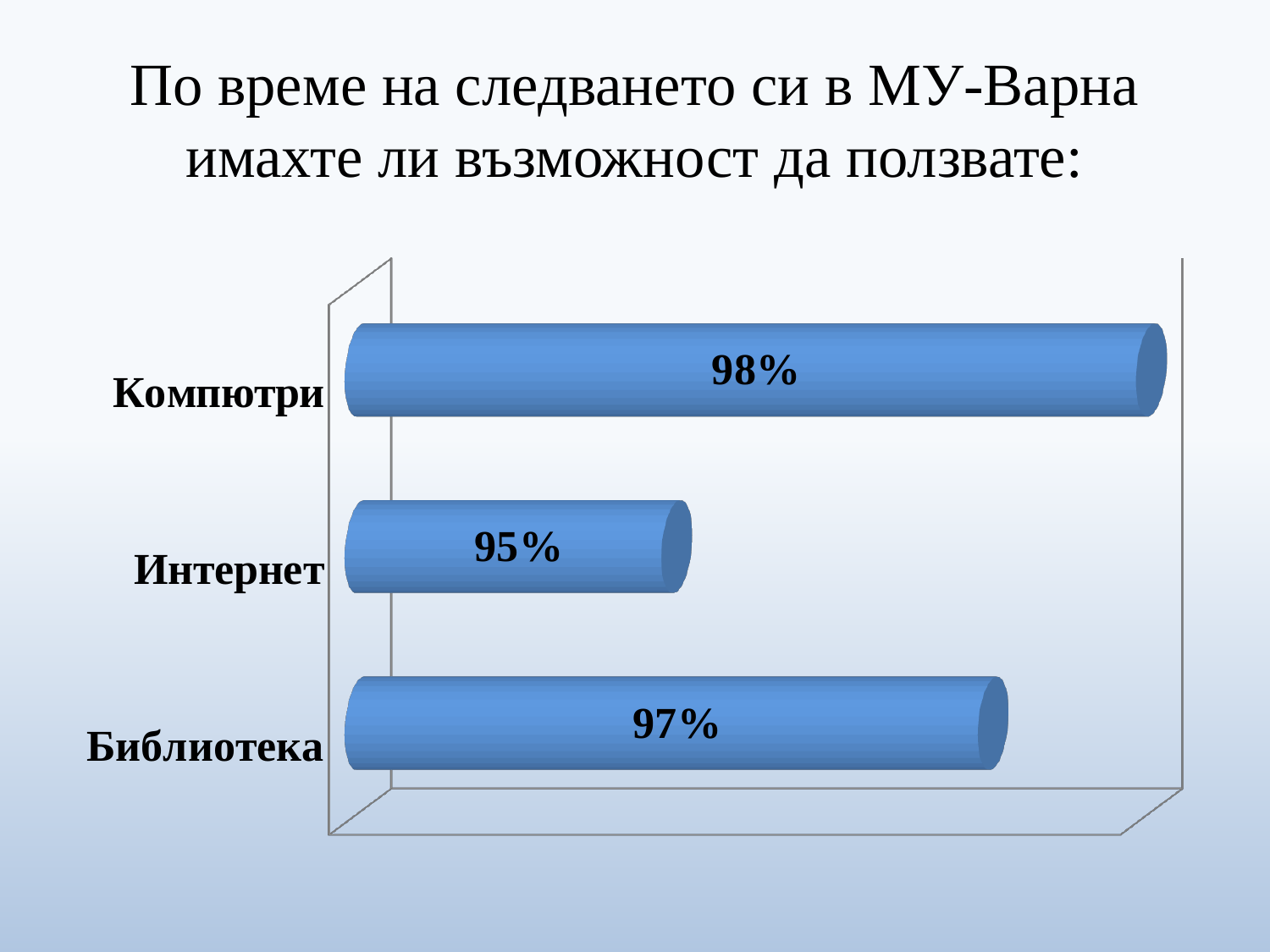
What is the title of the slide? По време на следването си в МУ-Варна имахте ли възможност да ползвате: Which is larger, the value for Библиотека or the value for Интернет? Библиотека Which category has the lowest value? Интернет What kind of chart is shown on the slide? Bar chart What is the value for Компютри? 98% What is the difference between the values for Компютри and Интернет? 3% What is the value for Интернет? 95% What is the difference between the values for Библиотека and Интернет? 2% How many categories are shown in the chart? 3 What is the value for Библиотека? 97% What colour are the bars in the chart? Blue Which category has the highest value? Компютри